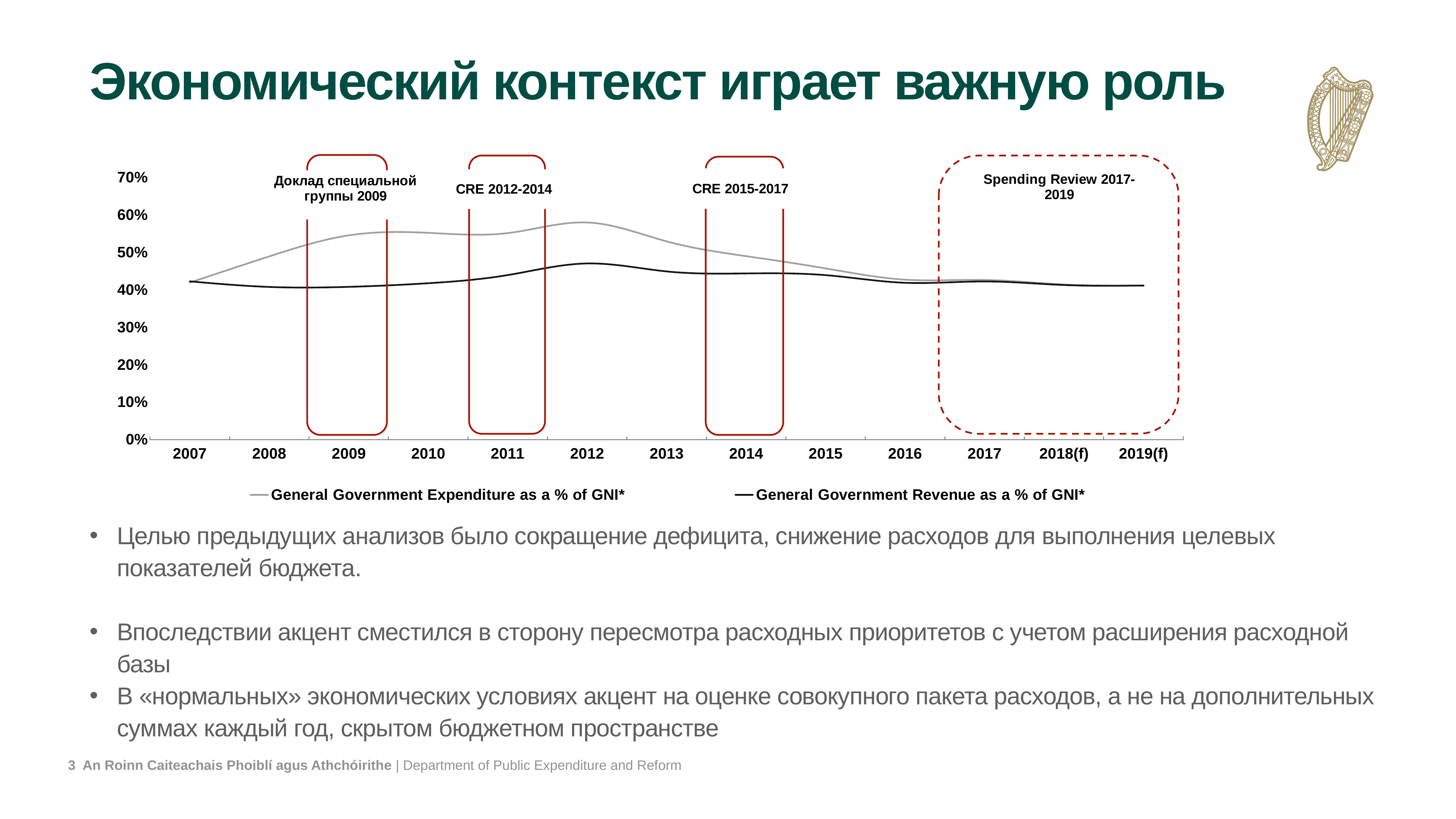
Does General Government Revenue as a % of GNI* rise or fall between 2009 and 2012? rise How many series does the chart legend list? 2 Is the value for General Government Expenditure as a % of GNI* in 2012 greater or less than 50%? greater How many years are shown along the x axis of the chart? 13 In which year does General Government Revenue as a % of GNI* reach its highest value? 2012 Does General Government Expenditure as a % of GNI* rise or fall between 2012 and 2016? fall Which series is drawn with the grey line in the chart? General Government Expenditure as a % of GNI* In 2012, which series has the larger value: General Government Expenditure as a % of GNI* or General Government Revenue as a % of GNI*? General Government Expenditure as a % of GNI* Is the value for General Government Revenue as a % of GNI* in 2009 greater or less than 50%? less What kind of chart is shown on the slide? line chart In which year does General Government Expenditure as a % of GNI* reach its highest value? 2012 Is the value for General Government Expenditure as a % of GNI* in 2007 greater or less than 50%? less